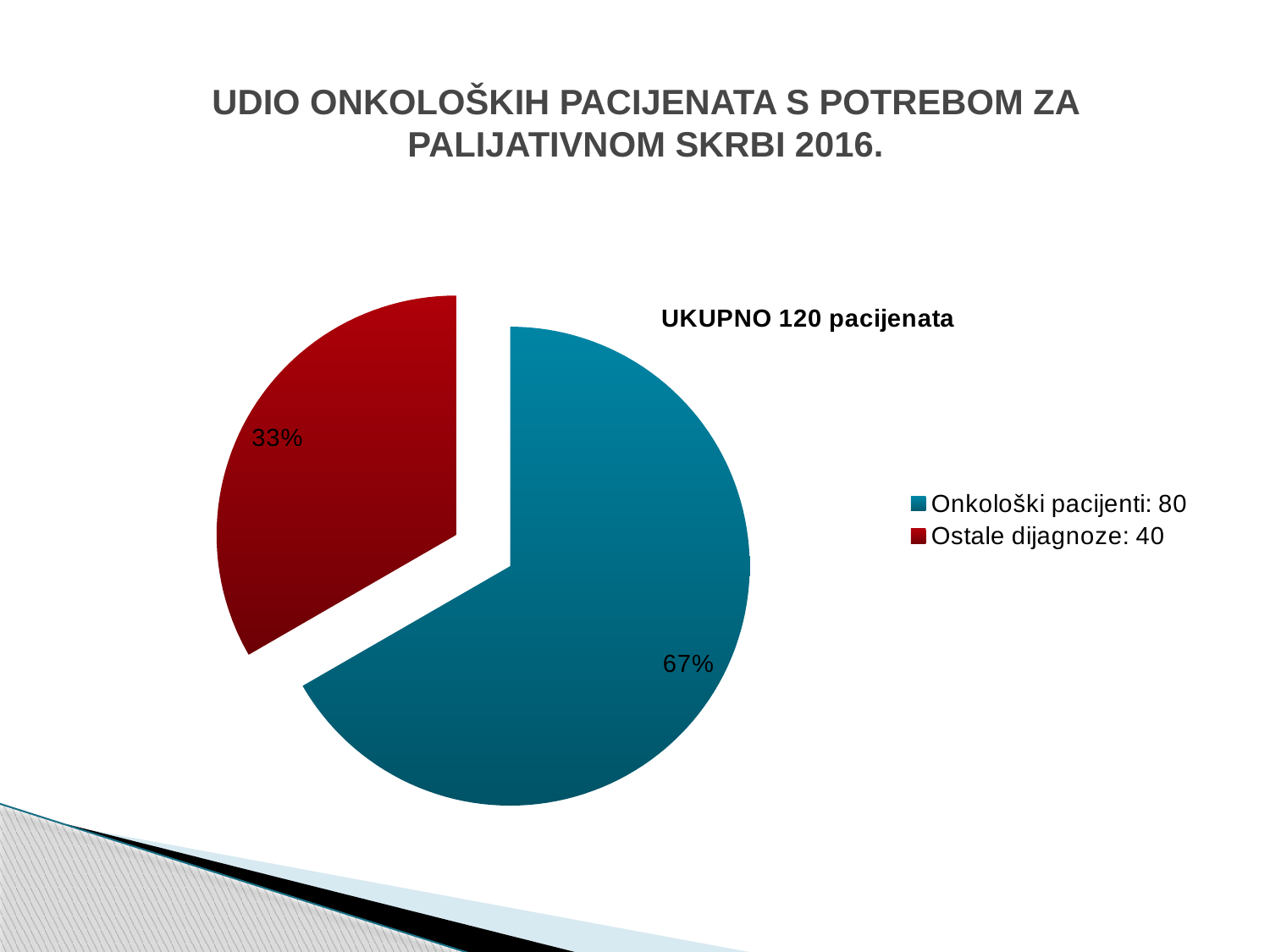
What is the total number of patients stated on the slide? 120 How many patients are in the 'Onkološki pacijenti' category according to the legend? 80 Which category has the largest slice of the pie? Onkološki pacijenti Which is larger: the share for 'Onkološki pacijenti' or for 'Ostale dijagnoze'? Onkološki pacijenti What share of the pie does the 'Ostale dijagnoze' slice represent? 33% What share of the pie does the 'Onkološki pacijenti' slice represent? 67% Which category has the smallest slice of the pie? Ostale dijagnoze What kind of chart is shown on the slide? pie chart How many slices does the pie chart have? 2 How many patients are in the 'Ostale dijagnoze' category according to the legend? 40 What colour is the 'Ostale dijagnoze' slice? red What is the difference in patient count between 'Onkološki pacijenti' and 'Ostale dijagnoze'? 40